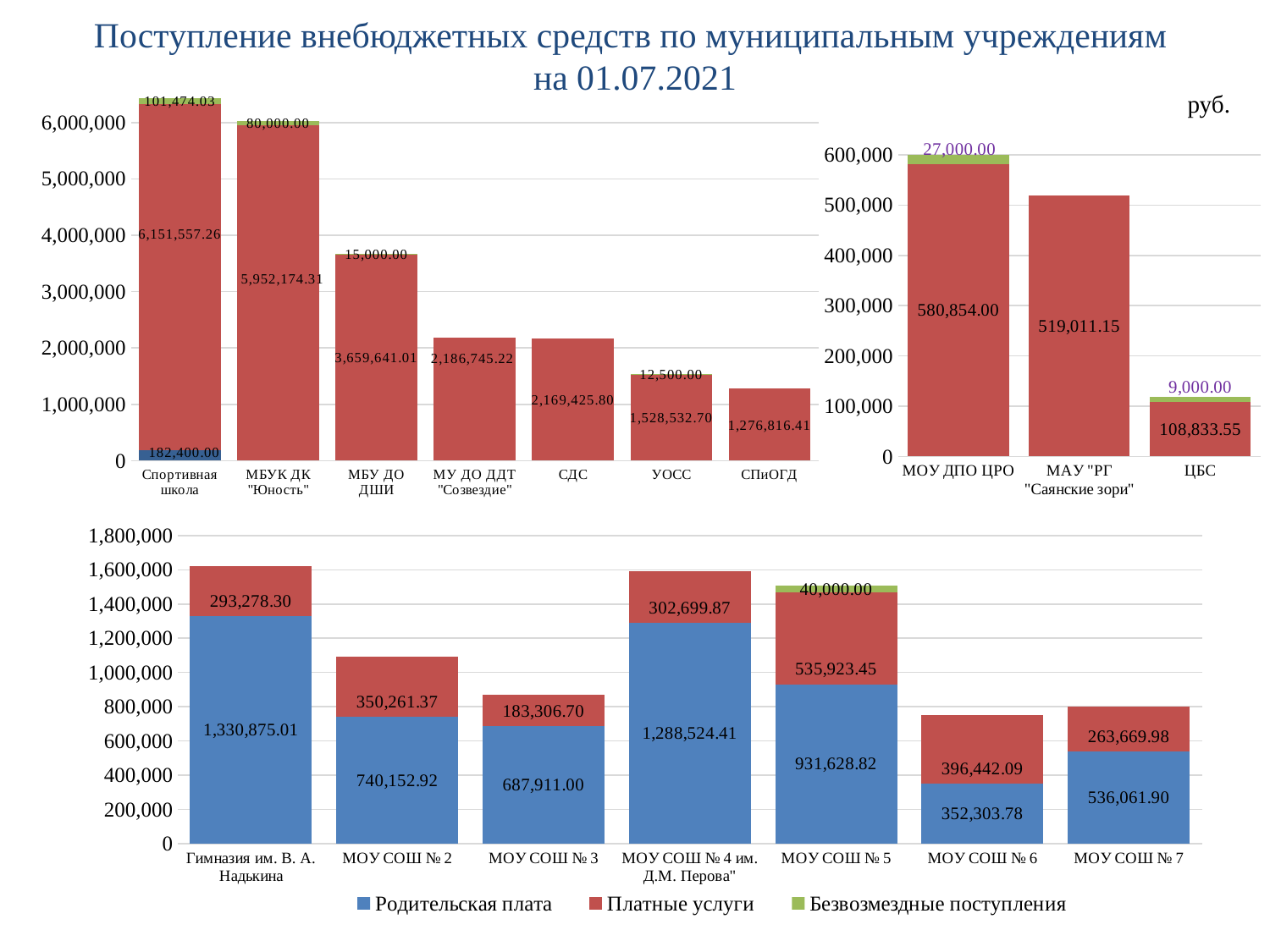
In the top-right chart, which institution has the highest value of Платные услуги? МОУ ДПО ЦРО In the top-left chart, what is the value of Безвозмездные поступления for УОСС? 12,500.00 In the bottom chart, for МОУ СОШ № 6, which is larger: Родительская плата or Платные услуги? Платные услуги In the top-right chart, what is the total of the stacked bar for ЦБС? 117,833.55 In the bottom chart, is the total bar for МОУ СОШ № 6 greater or less than 800,000? less In the top-left chart, which institution has the lowest total bar? СПиОГД In the bottom chart, what is the difference between the Родительская плата values for Гимназия им. В. А. Надькина and МОУ СОШ № 4 им. Д.М. Перова"? 42,350.60 How many series does the legend list? 3 In the bottom chart, what is the value of Родительская плата for МОУ СОШ № 3? 687,911.00 How many institutions are shown in the bottom chart? 7 In the top-left chart, what is the value of Платные услуги for СДС? 2,169,425.80 In the top-right chart, what is the value of Платные услуги for МАУ "РГ "Саянские зори"? 519,011.15